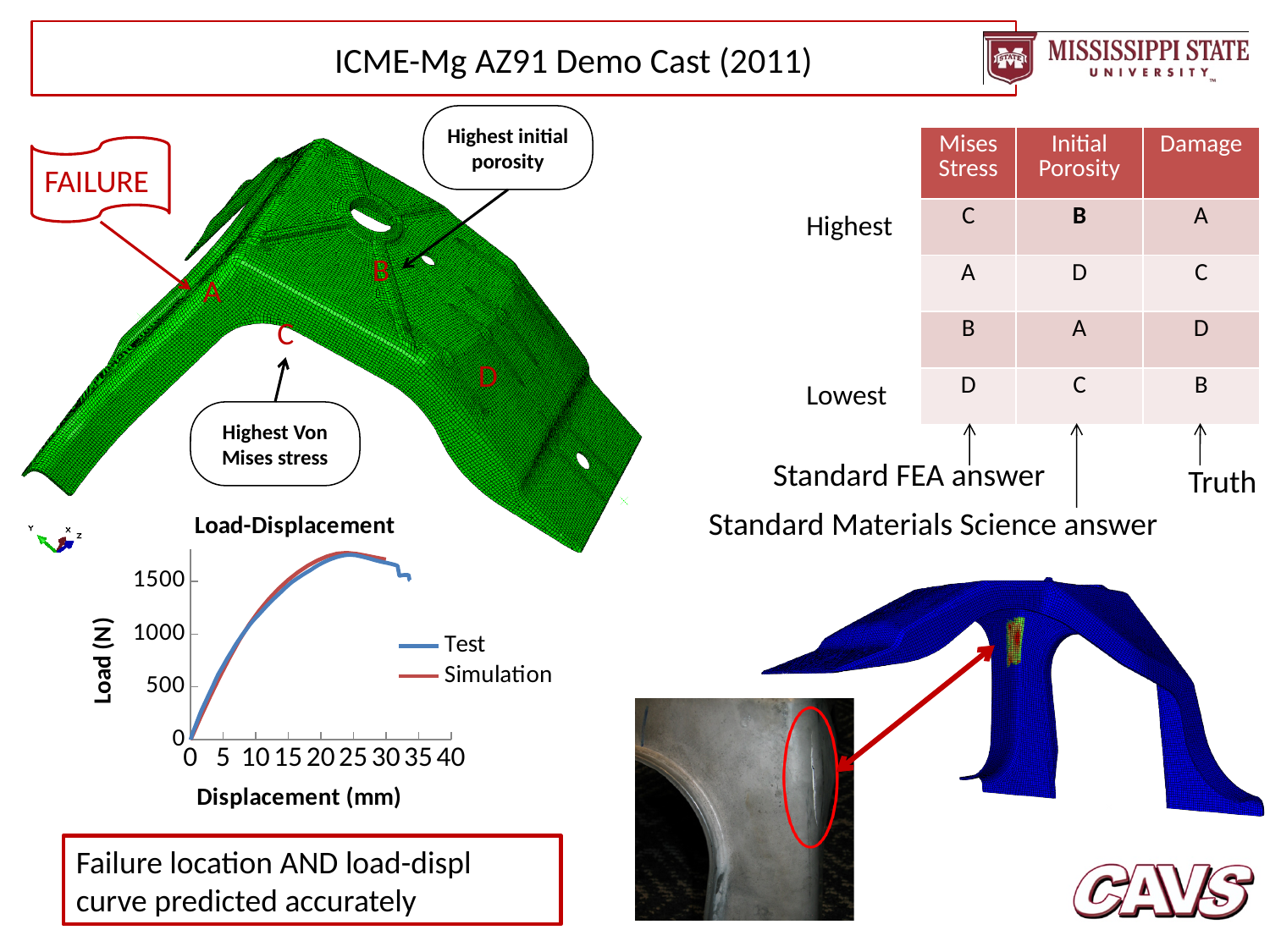
How many series does the legend of the Load-Displacement chart list? 2 What is the title of the chart on the slide? Load-Displacement In the Load-Displacement chart, is the maximum displacement reached by the Test curve greater or less than 30 mm? greater What kind of chart is the Load-Displacement chart? line chart In the Load-Displacement chart, is the load at a displacement of 10 mm greater or less than 1000? greater In the Load-Displacement chart, is the peak load of the Test curve greater or less than 1500? greater In the Load-Displacement chart, which series extends to a larger displacement, Test or Simulation? Test In the Load-Displacement chart, does the load rise or fall as displacement increases from 0 to 20 mm? rise What is the label of the y axis of the Load-Displacement chart? Load (N)